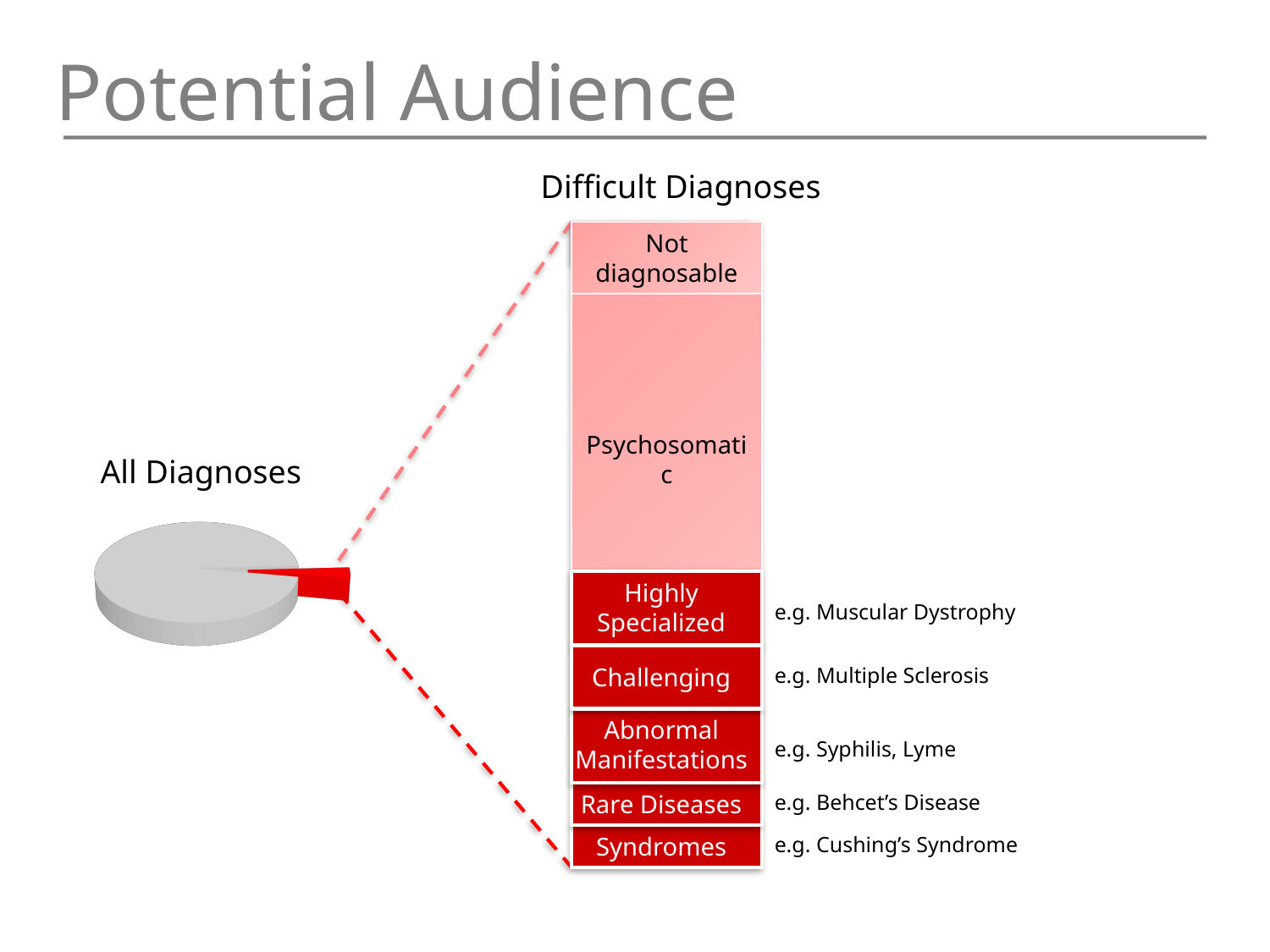
In the 'All Diagnoses' pie chart, which is larger, the grey slice or the red slice? The grey slice What kind of chart is the 'All Diagnoses' chart on the left of the slide? Pie chart What kind of chart is the 'Difficult Diagnoses' chart on the right of the slide? Stacked bar chart In the 'Difficult Diagnoses' chart, what example is given next to the 'Challenging' segment? e.g. Multiple Sclerosis How many segments does the 'Difficult Diagnoses' stacked bar contain? 7 How many slices does the 'All Diagnoses' pie chart have? 2 In the 'Difficult Diagnoses' chart, which is larger, the 'Psychosomatic' segment or the 'Highly Specialized' segment? Psychosomatic In the 'Difficult Diagnoses' chart, which segment is at the top of the stacked bar? Not diagnosable In the 'Difficult Diagnoses' chart, which is larger, the 'Abnormal Manifestations' segment or the 'Syndromes' segment? Abnormal Manifestations In the 'Difficult Diagnoses' chart, which segment is the largest? Psychosomatic